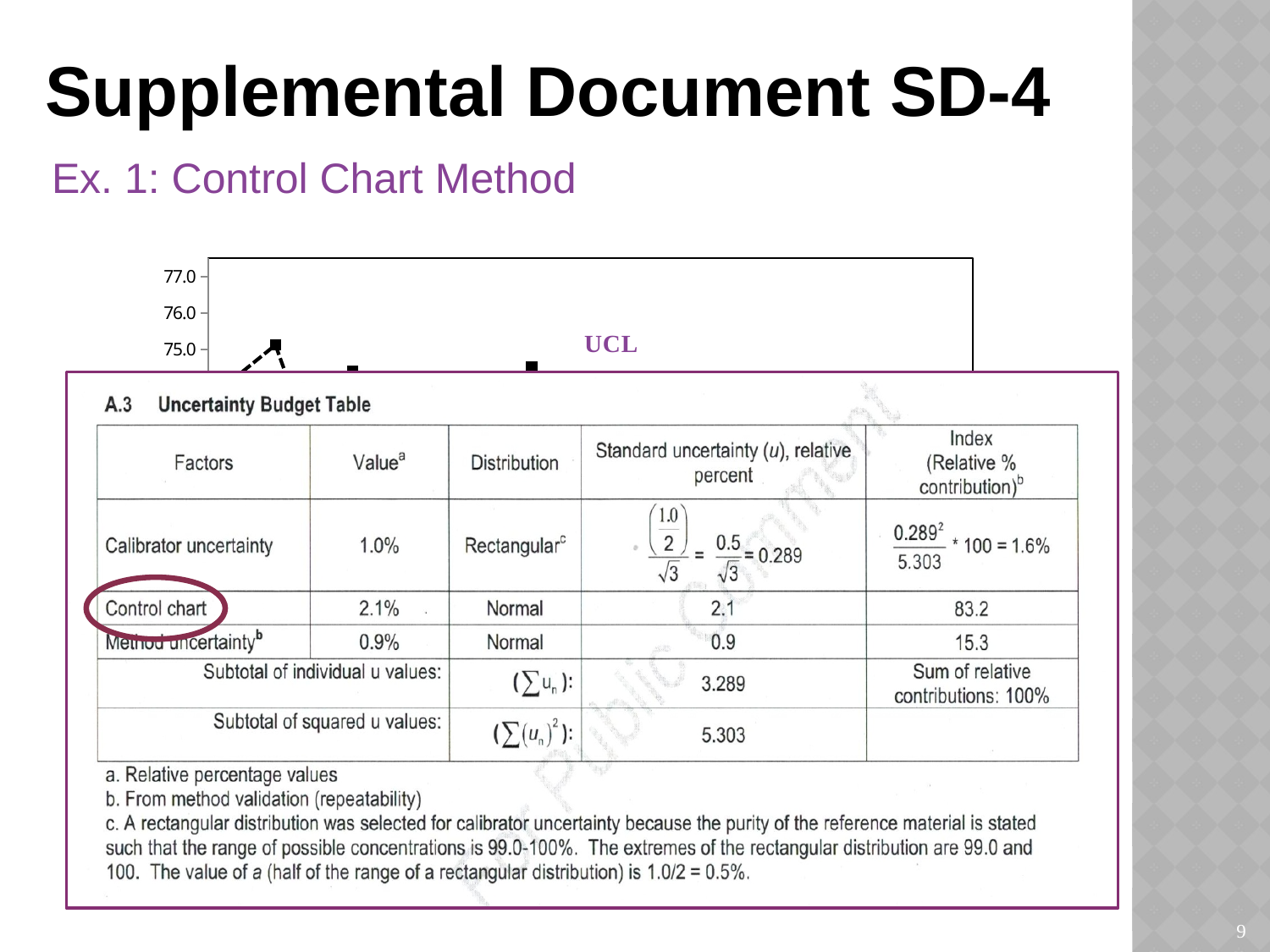
What kind of chart is partially visible on the slide? line chart Is the value of the first visible data point on the chart greater or less than 77.0? less Is the value of the first visible data point on the chart greater or less than 76.0? less What label is printed inside the plot area of the chart? UCL What is the highest y-axis tick value shown on the chart? 77.0